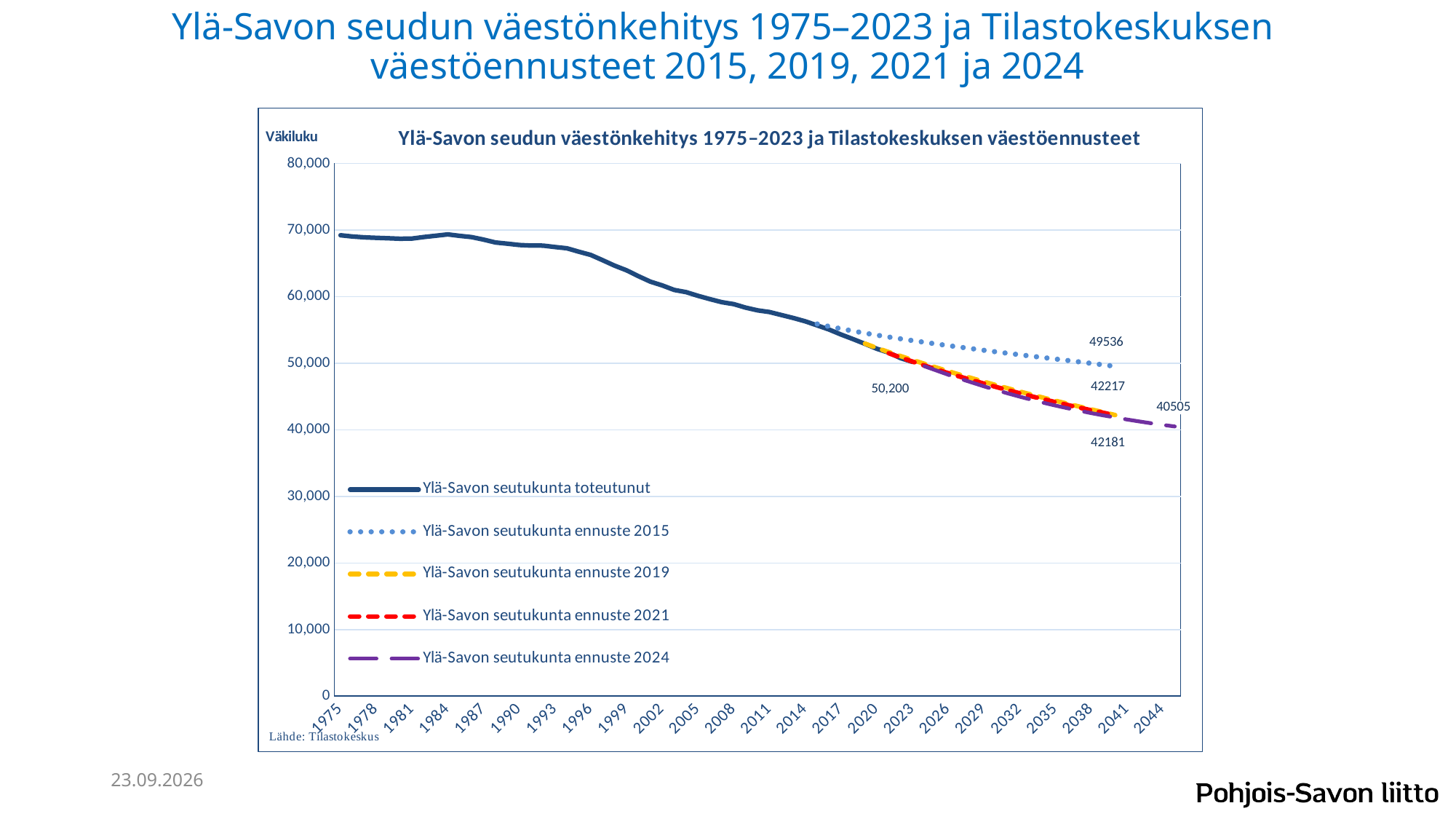
What is the labelled value at the end of the 'Ylä-Savon seutukunta toteutunut' series? 50,200 What is the final labelled value of the 'Ylä-Savon seutukunta ennuste 2021' series? 42181 Is the value of the 'Ylä-Savon seutukunta toteutunut' series in 1975 greater or less than 60,000? greater What is the final labelled value of the 'Ylä-Savon seutukunta ennuste 2024' series? 40505 Does the 'Ylä-Savon seutukunta toteutunut' series generally rise or fall from 1975 to 2023? fall Which forecast series ends at a higher labelled value, ennuste 2015 or ennuste 2024? Ylä-Savon seutukunta ennuste 2015 What kind of chart is shown on the slide? line chart What is the difference between the final labelled values of the 2015 forecast (49536) and the 2024 forecast (40505)? 9031 How many series does the legend list? 5 What is the final labelled value of the 'Ylä-Savon seutukunta ennuste 2019' series? 42217 What is the final labelled value of the 'Ylä-Savon seutukunta ennuste 2015' series? 49536 What label is shown on the vertical axis of the chart? Väkiluku